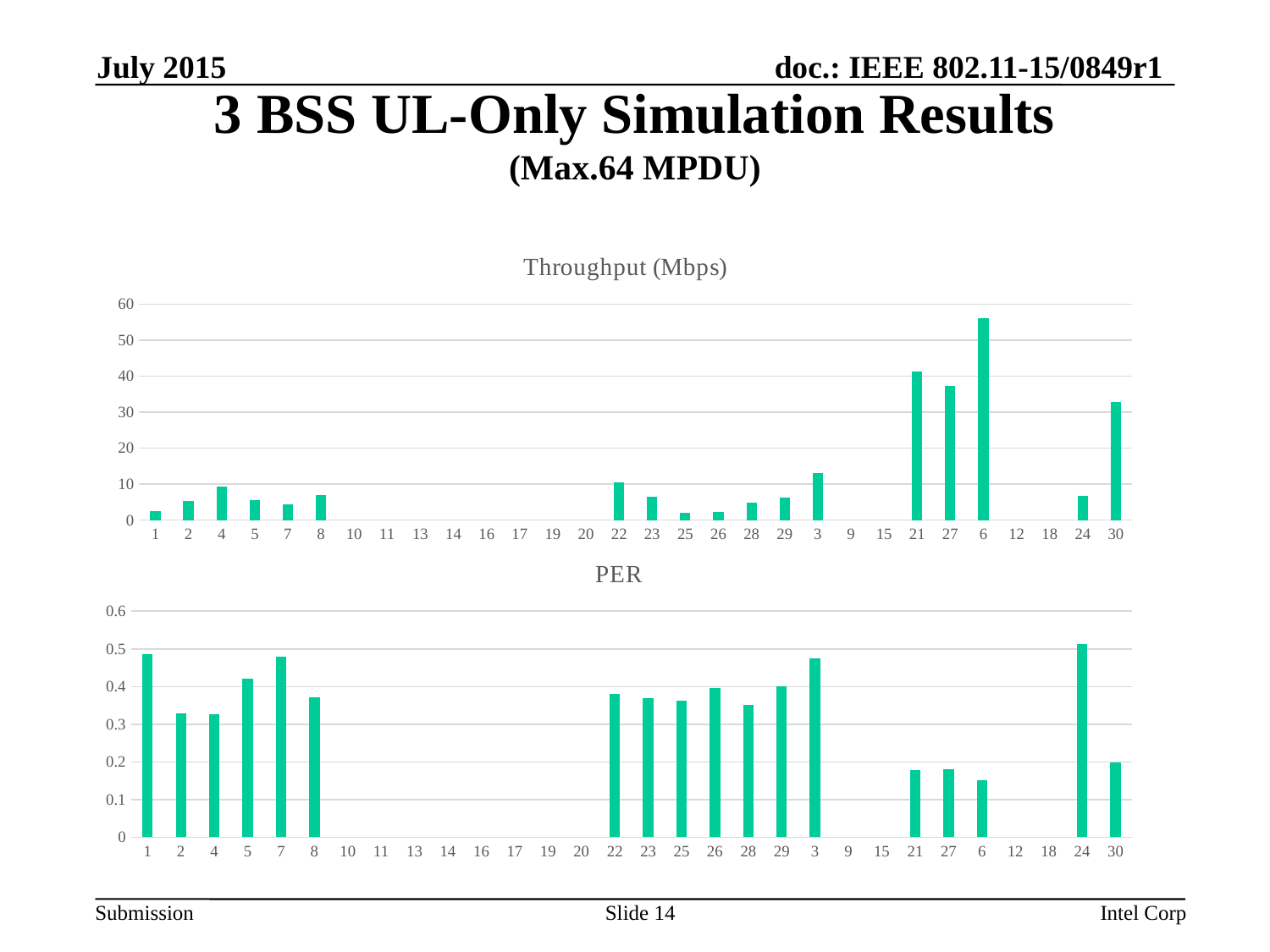
In the Throughput (Mbps) chart, which is larger, the value for category 6 or category 30? 6 In the PER chart, is the value for category 21 greater or less than 0.2? less In the PER chart, is the value for category 22 greater or less than 0.3? greater In the Throughput (Mbps) chart, which category has the highest throughput? 6 What kind of chart is the Throughput (Mbps) chart? bar chart In the Throughput (Mbps) chart, is the value for category 1 greater or less than 10? less In the PER chart, which is larger, the value for category 5 or category 2? 5 What is the title of the top chart on the slide? Throughput (Mbps) In the Throughput (Mbps) chart, which is larger, the value for category 21 or category 27? 21 How many categories are shown on the x axis of the PER chart? 30